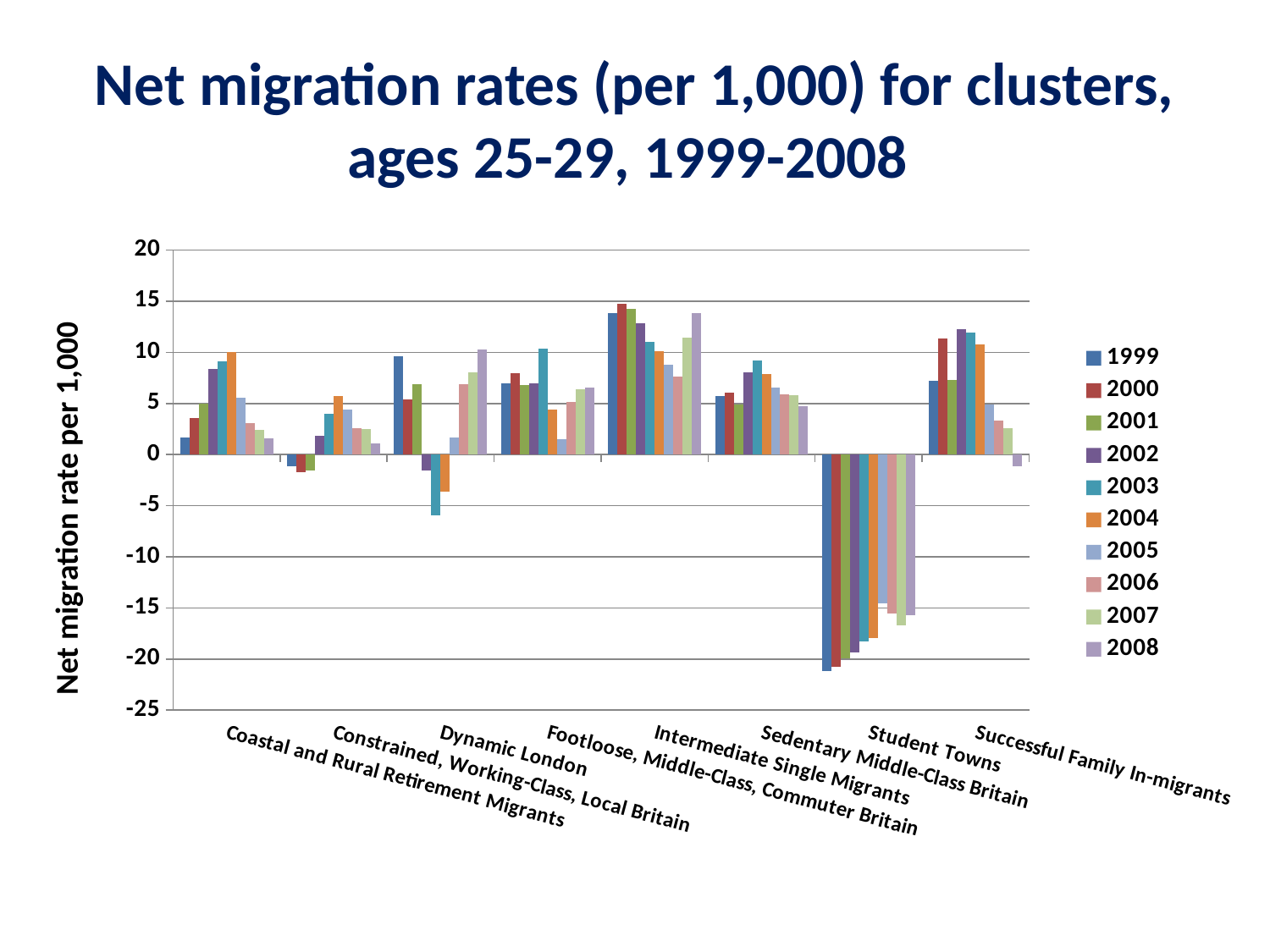
How many series (years) does the legend list? 10 For Dynamic London, which is lower: the value for 2003 or the value for 2004? 2003 How many clusters are shown along the x axis? 8 What kind of chart is shown on the slide? bar chart What is the title of the vertical axis? Net migration rate per 1,000 For Successful Family In-migrants, which is larger: the value for 1999 or the value for 2008? 1999 Is the value for Student Towns in 1999 greater or less than -15? less Do the values for Student Towns rise or fall from 1999 to 2008? rise Which cluster has the lowest (most negative) net migration rates? Student Towns Which cluster contains the single highest bar on the chart? Intermediate Single Migrants Is the value for Coastal and Rural Retirement Migrants in 2004 greater or less than 5? greater